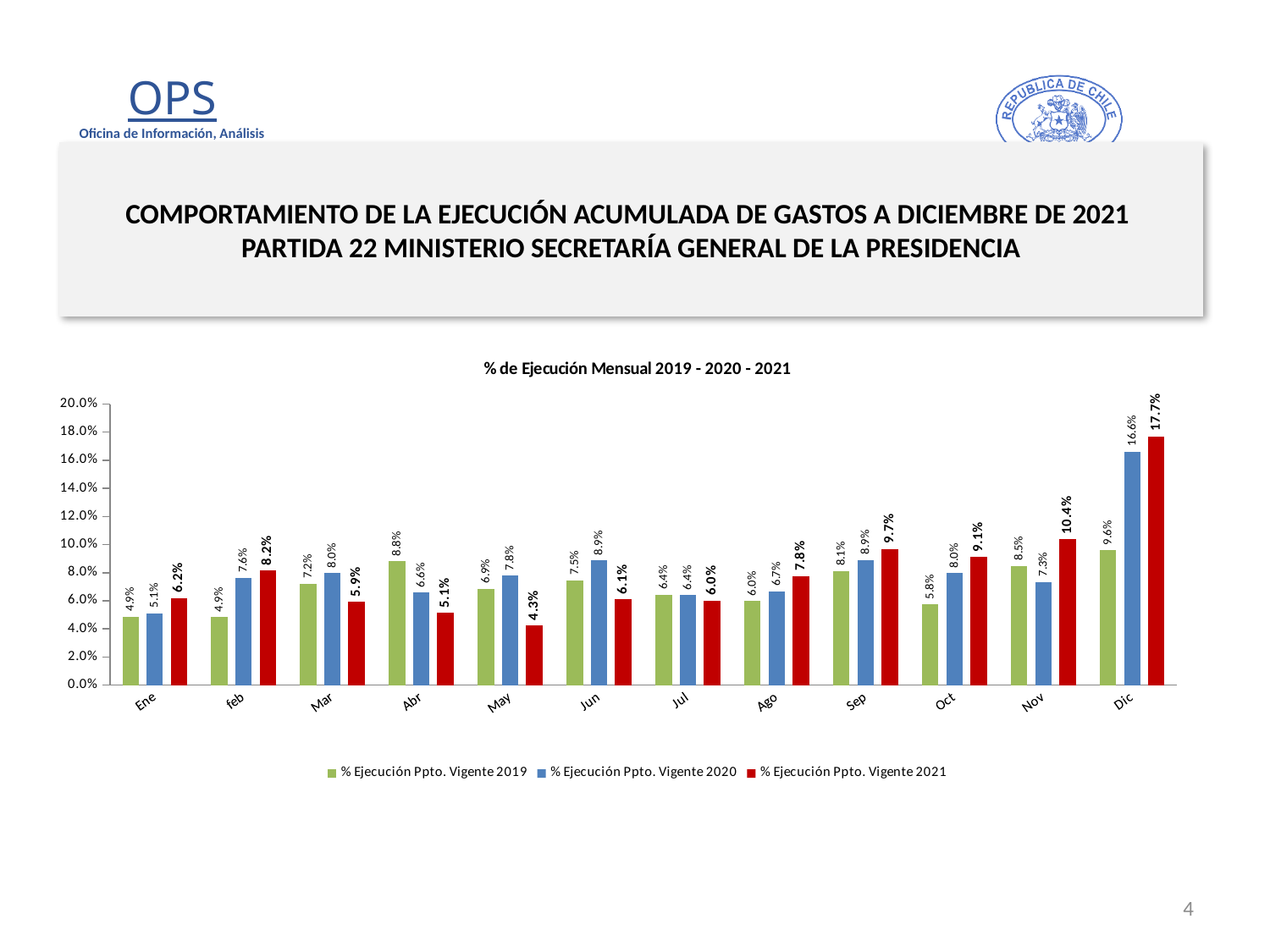
What is the value for % Ejecución Ppto. Vigente 2019 in Abr? 8.8% How many months are shown on the x axis? 12 What is the value for % Ejecución Ppto. Vigente 2020 in Jun? 8.9% In which month is the % Ejecución Ppto. Vigente 2019 value highest? Dic Is the value for % Ejecución Ppto. Vigente 2020 in Dic greater or less than 14.0%? greater What is the value for % Ejecución Ppto. Vigente 2021 in Dic? 17.7% What is the title of the chart? % de Ejecución Mensual 2019 - 2020 - 2021 Which is larger in Nov: the % Ejecución Ppto. Vigente 2019 value or the % Ejecución Ppto. Vigente 2020 value? % Ejecución Ppto. Vigente 2019 What is the difference between the 2021 and 2020 values in Dic? 1.1% How many series does the legend list? 3 What type of chart is shown on the slide? bar chart In which month is the % Ejecución Ppto. Vigente 2021 value lowest? May